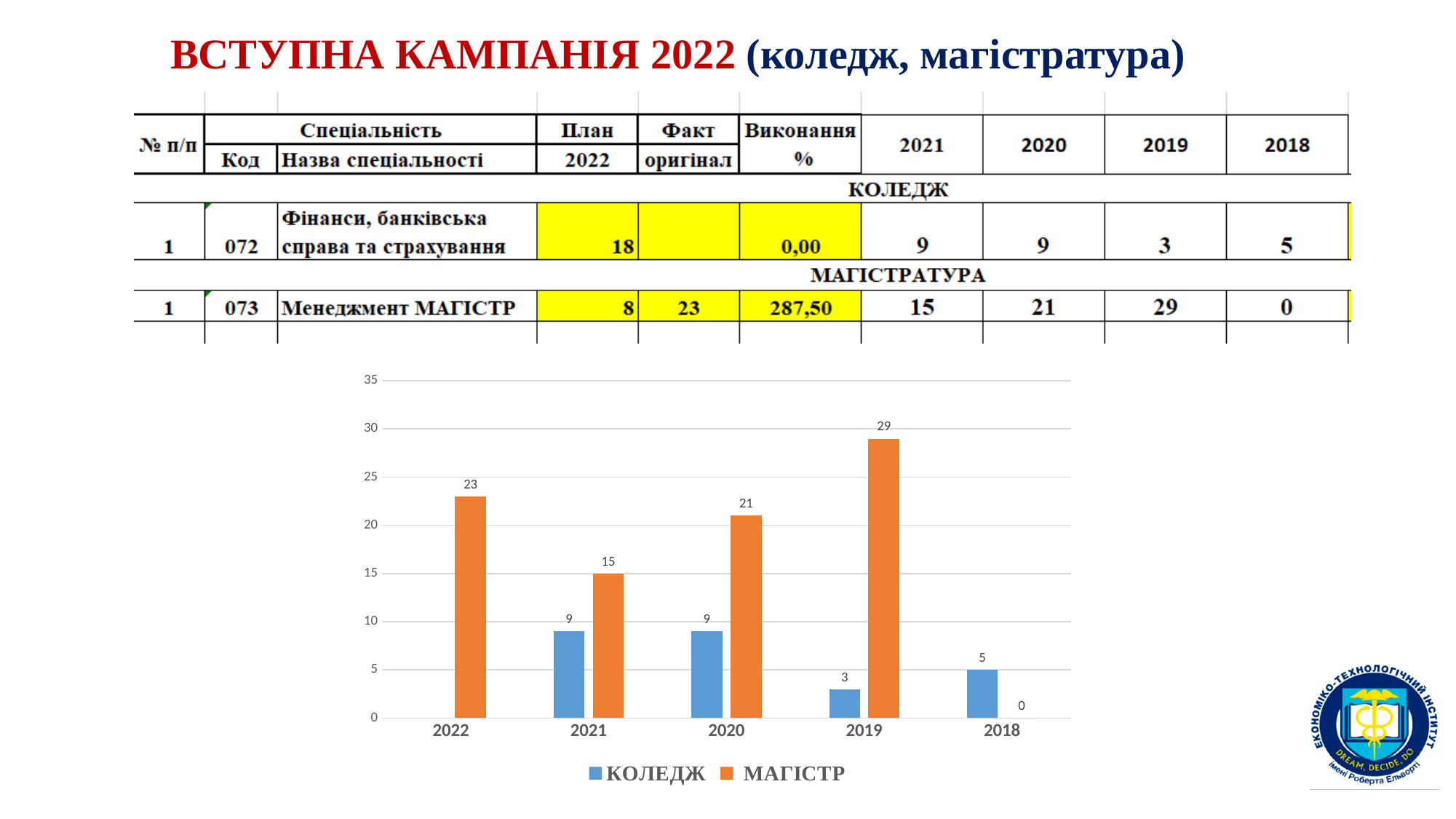
What is the value for МАГІСТР in 2019? 29 What is the value for КОЛЕДЖ in 2018? 5 Which colour represents the КОЛЕДЖ series in the chart? blue How many series does the chart legend list? 2 Which is larger in 2020, the КОЛЕДЖ value or the МАГІСТР value? МАГІСТР In which year is the МАГІСТР value highest? 2019 Is the МАГІСТР value for 2020 greater or less than 15? greater In which year is the МАГІСТР value lowest? 2018 What is the difference between the МАГІСТР values for 2019 and 2021? 14 What is the value for МАГІСТР in 2022? 23 How many years are shown on the x axis of the chart? 5 What type of chart is shown on the slide? bar chart